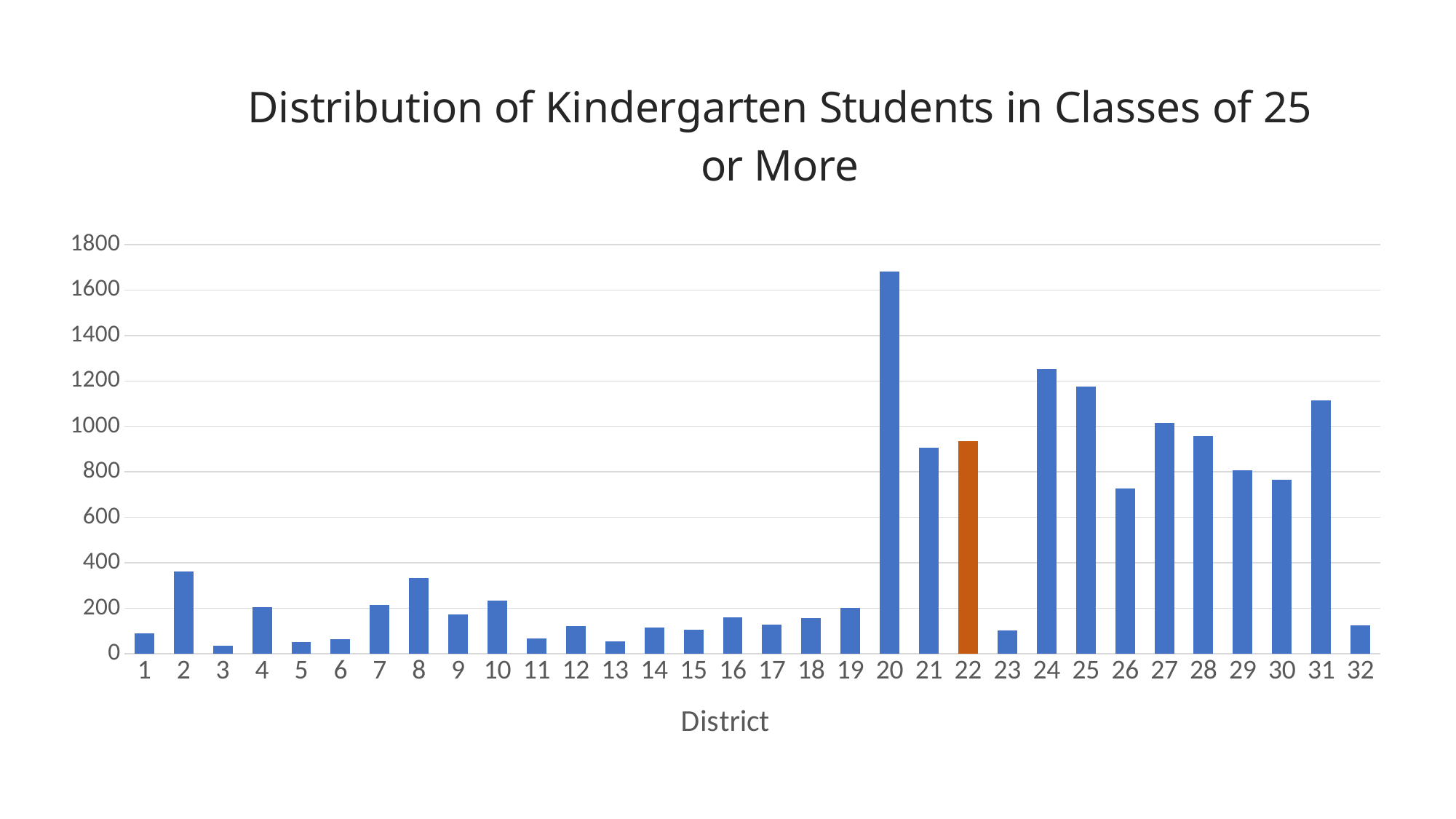
Is the value for district 24 greater or less than 1200? greater Is the value for district 31 greater or less than 1000? greater Is the value for district 22 greater or less than 1000? less What kind of chart is shown on the slide? Bar chart Which district's bar is highlighted in orange rather than blue? District 22 How many districts are shown on the x axis of the chart? 32 Which has the larger value, district 20 or district 31? District 20 Which district has the highest number of kindergarten students in classes of 25 or more? District 20 Which has the larger value, district 24 or district 25? District 24